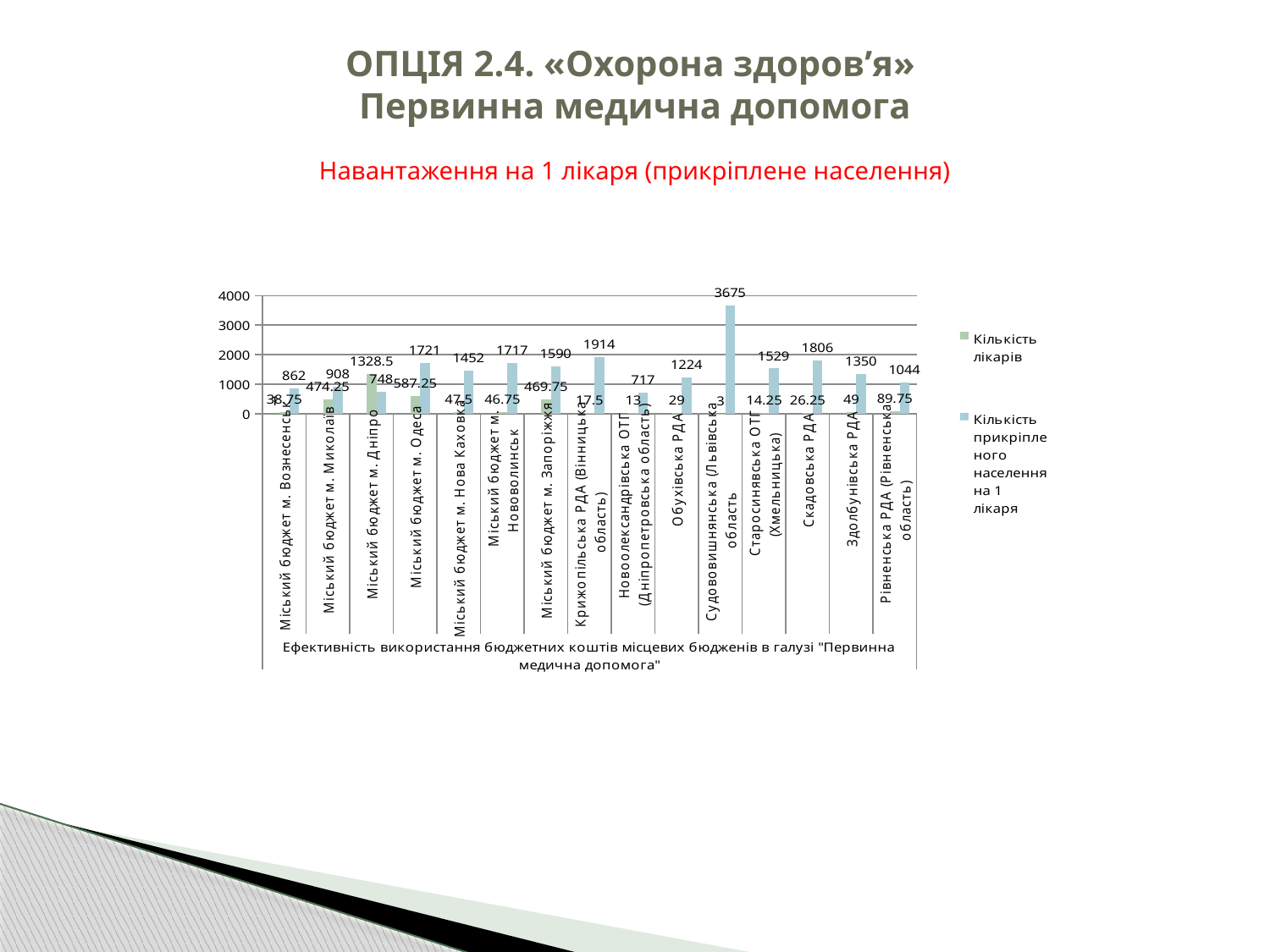
What is the number of attached population per doctor (Кількість прикріпленого населення на 1 лікаря) for Міський бюджет м. Одеса? 1721 Which category has the highest number of doctors? Міський бюджет м. Дніпро What is the number of doctors for Рівненська РДА (Рівненська область)? 89.75 Which category has the highest number of attached population per doctor? Судововишнянська (Львівська область) How many series does the legend list? 2 What is the number of doctors (Кількість лікарів) for Міський бюджет м. Дніпро? 1328.5 Which has a larger attached population per doctor: Скадовська РДА or Здолбунівська РДА? Скадовська РДА What is the number of attached population per doctor for Скадовська РДА? 1806 How many categories are shown on the x axis of the chart? 15 Which category has the lowest number of attached population per doctor? Новоолександрівська ОТГ (Дніпропетровська область) What kind of chart is shown on the slide? Bar chart What is the difference in attached population per doctor between Судововишнянська (Львівська область) and Крижопільська РДА (Вінницька область)? 1761